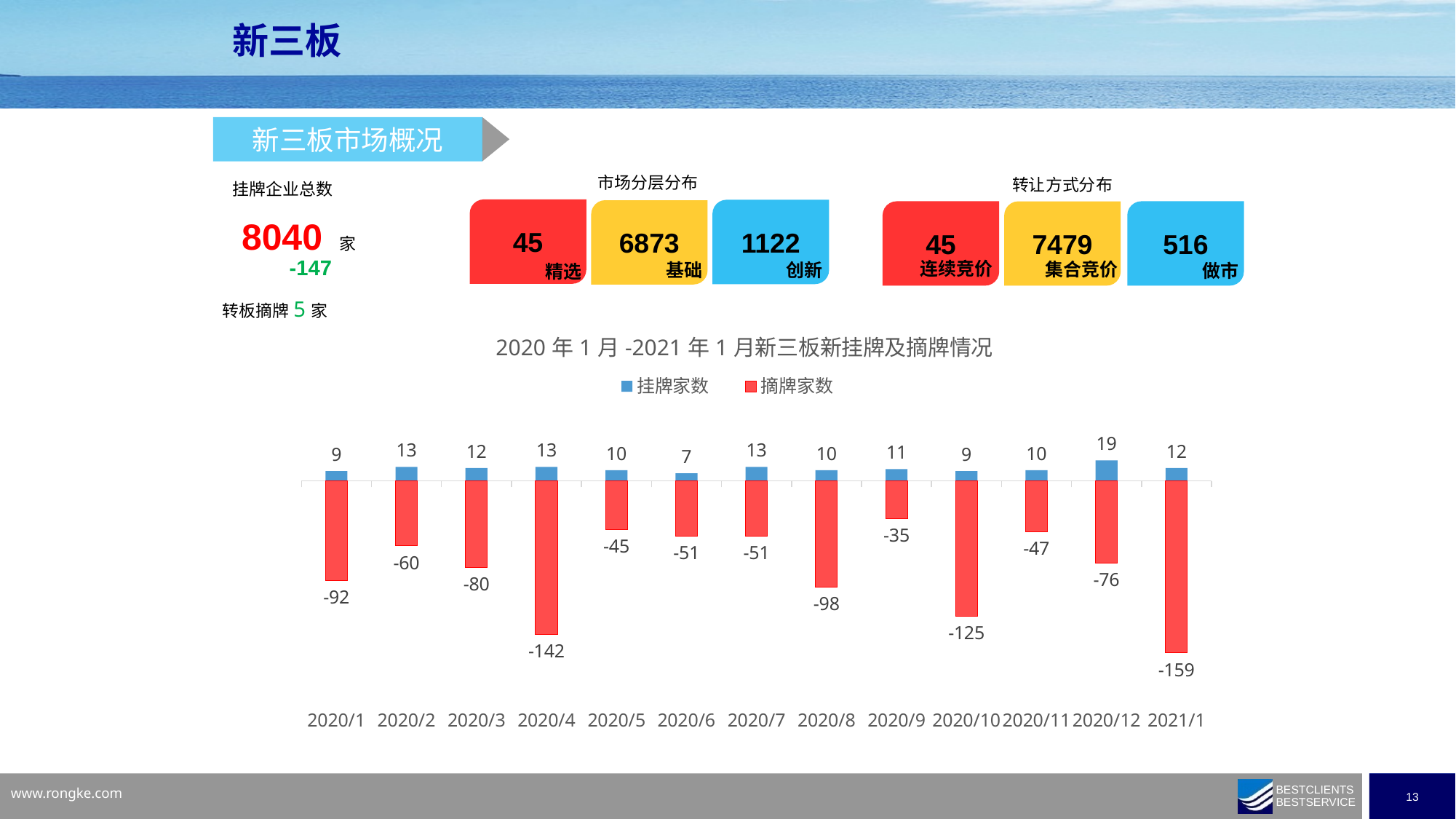
What is the 摘牌家数 value for 2020/4? -142 Which month has the lowest 摘牌家数 value (the largest number of delistings)? 2021/1 Which colour represents 摘牌家数 in the chart? Red What kind of chart is used to show 新挂牌及摘牌情况? Bar chart What is the 挂牌家数 value for 2020/12? 19 What is the 摘牌家数 value for 2021/1? -159 Which month has the lowest 挂牌家数 value? 2020/6 How many months are shown on the x axis of the chart? 13 What is the difference between the 挂牌家数 values for 2020/12 and 2020/6? 12 Which is larger in magnitude, the 摘牌家数 for 2020/10 or for 2020/8? 2020/10 How many series does the chart legend list? 2 Which month has the highest 挂牌家数 value? 2020/12